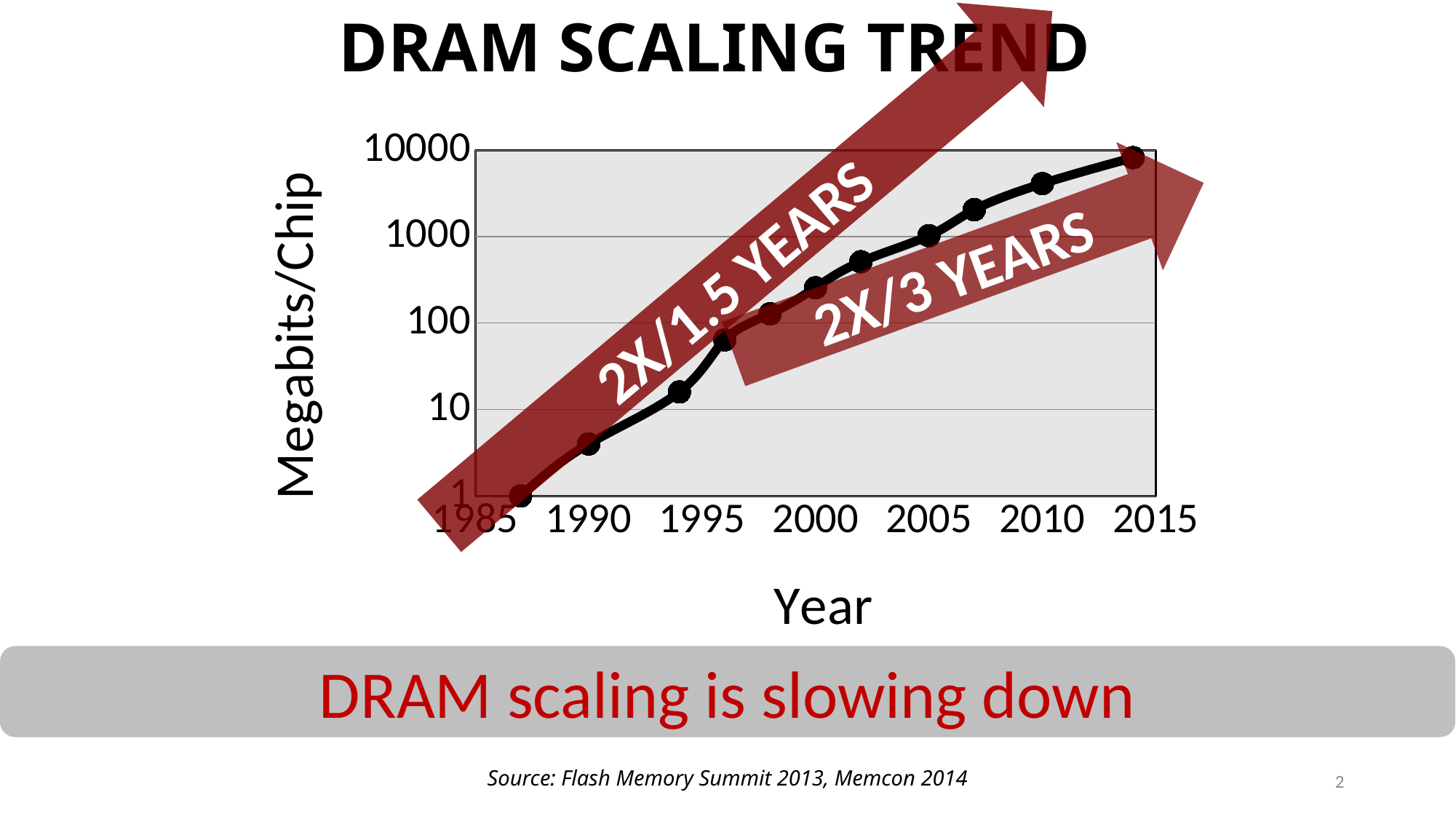
Is the value for the point near 2014 greater or less than 1000? greater Is the value for the point near 2010 greater or less than 1000? greater Is the value for the point near 1996 greater or less than 100? less Which is larger, the value near 2010 or the value near 1990? 2010 Do the values rise or fall as the year increases along the x axis? rise What is the label of the y axis? Megabits/Chip What kind of chart is shown on the slide? line chart What is the title of the chart? DRAM SCALING TREND Around which year does the line have its lowest value? 1987 Around which year does the line reach its highest value? 2014